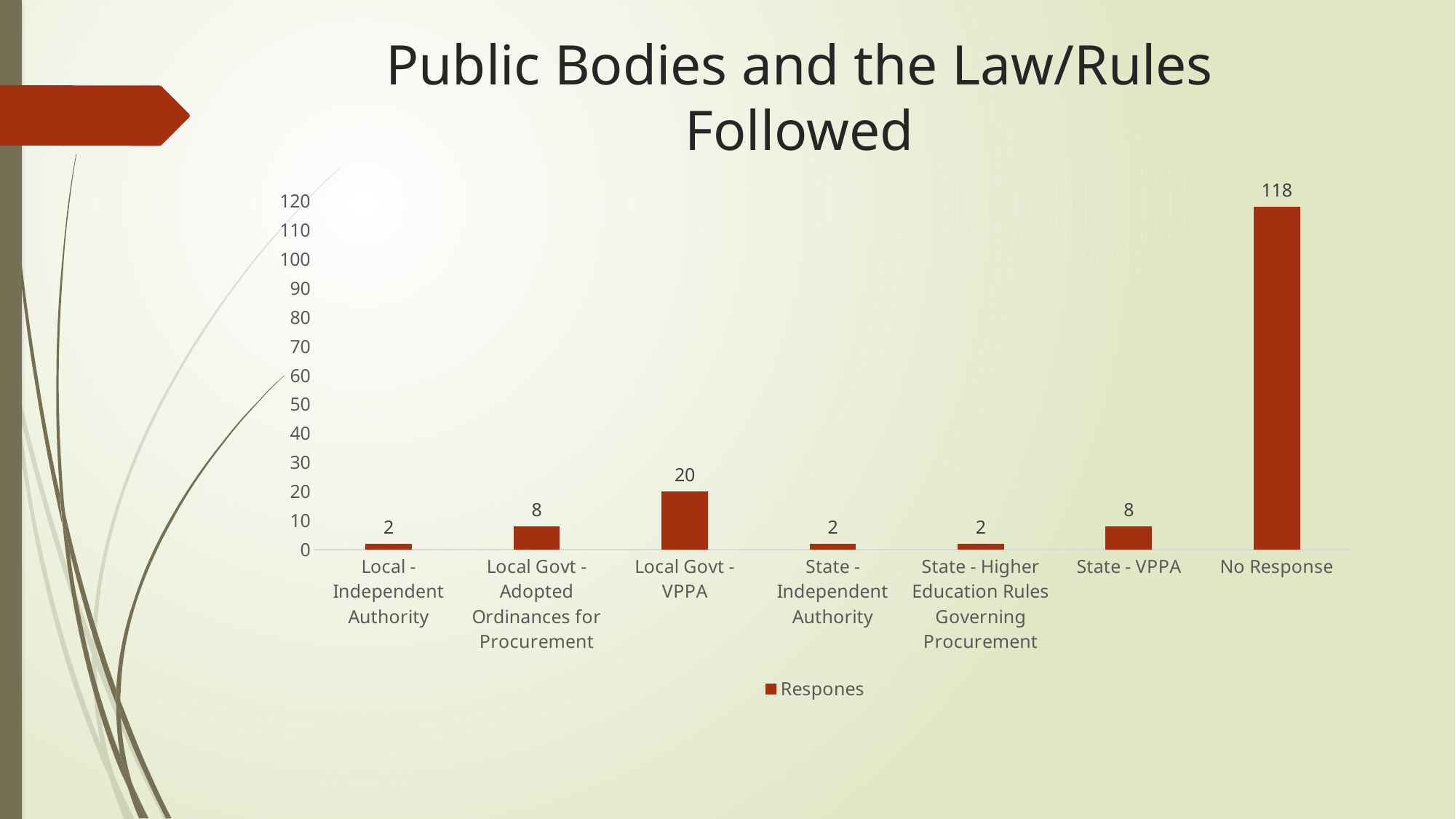
What is the value for No Response? 118 What kind of chart is shown on the slide? bar chart Which is larger, the value for Local Govt - VPPA or the value for State - VPPA? Local Govt - VPPA What is the name of the series listed in the legend? Respones What is the value for Local Govt - VPPA? 20 What is the difference between the values for Local Govt - VPPA and Local Govt - Adopted Ordinances for Procurement? 12 What is the value for State - VPPA? 8 Is the value for No Response greater or less than 100? greater What is the difference between the values for No Response and Local Govt - VPPA? 98 What is the value for State - Higher Education Rules Governing Procurement? 2 How many categories are shown on the x axis? 7 Which category has the highest value? No Response